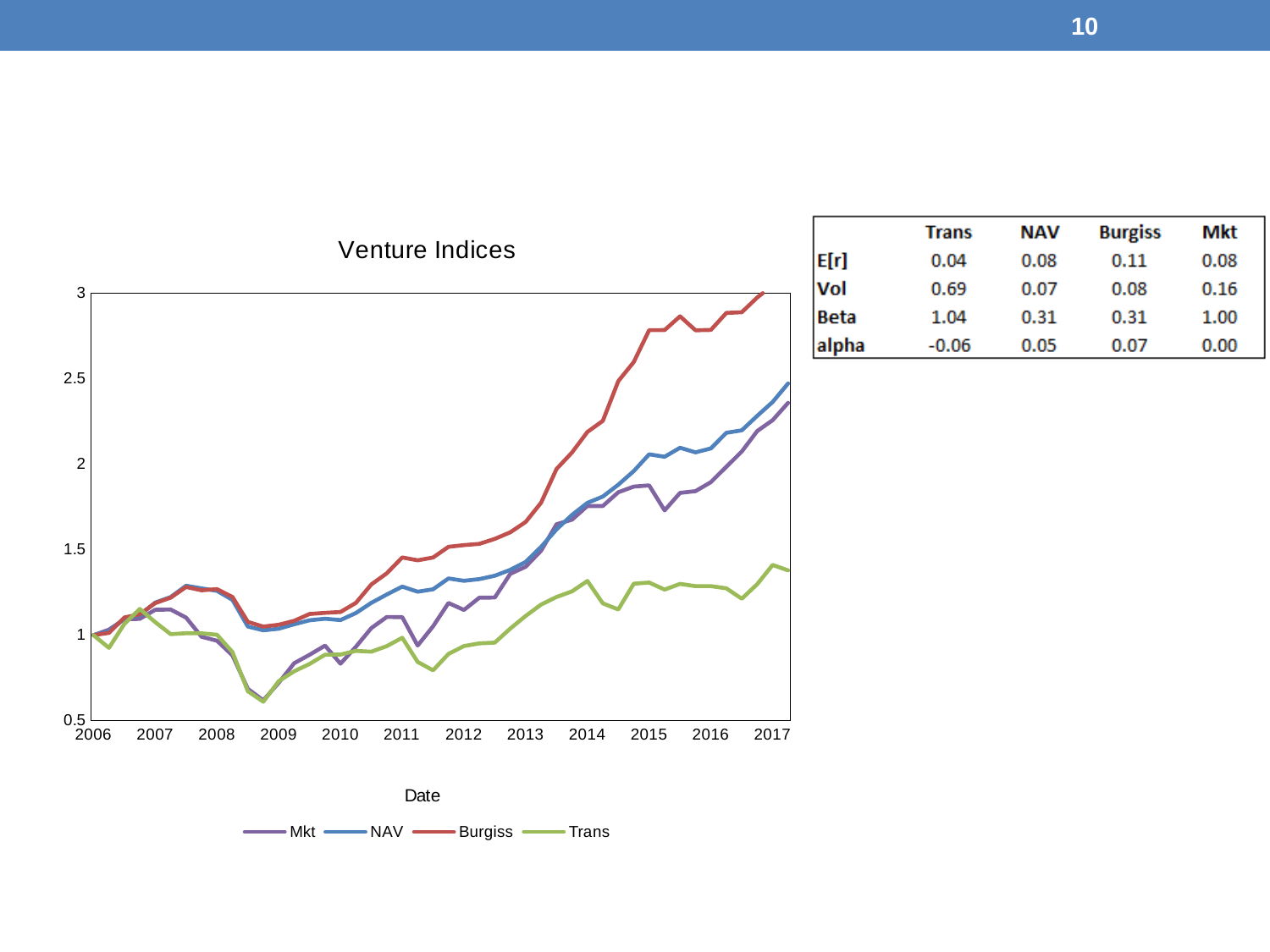
Is the value of the NAV series at 2015 greater or less than 1.5? greater What kind of chart is shown on the slide? line chart Is the value of the Burgiss series at 2017 greater or less than 2.5? greater Is the value of the Trans series at 2017 greater or less than 1.5? less How many year labels are shown on the x axis? 12 How many series does the chart's legend list? 4 Which series has the highest value at the right end of the chart (2017)? Burgiss Which series has the lowest value at the right end of the chart (2017)? Trans What is the label of the x axis? Date At 2016, which series is larger, Burgiss or Trans? Burgiss Does the Burgiss series generally rise or fall from 2009 to 2017? rise What is the title of the chart? Venture Indices